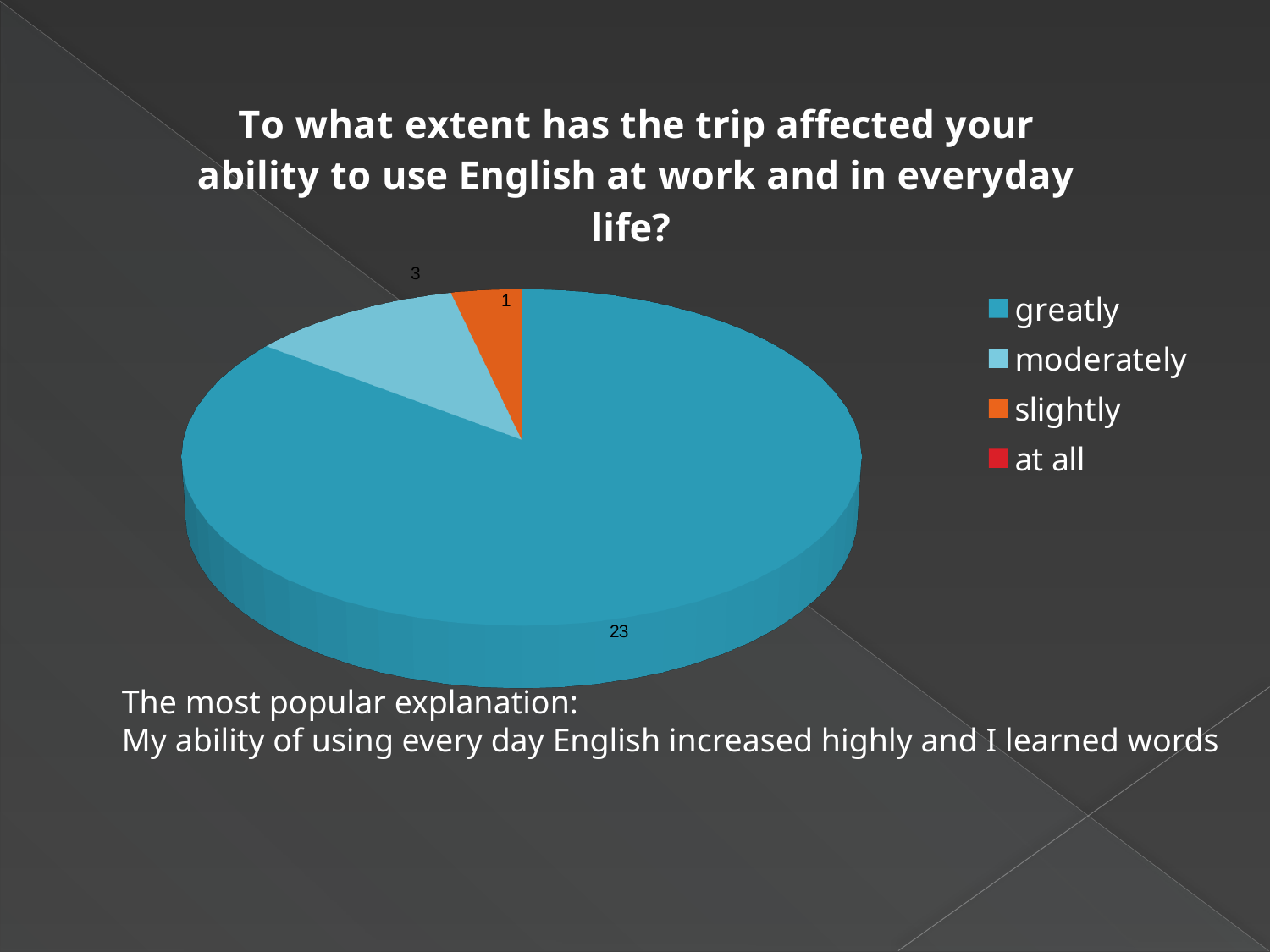
What is the difference between the 'greatly' value and the 'moderately' value? 20 What is the value for the 'moderately' slice? 3 What is the title of the chart? To what extent has the trip affected your ability to use English at work and in everyday life? What is the value for the 'slightly' slice? 1 Which is larger, the 'moderately' slice or the 'slightly' slice? moderately What is the value for the 'greatly' slice? 23 Which category is shown in orange in the legend? slightly What is the difference between the 'greatly' value and the 'slightly' value? 22 How many categories does the legend list? 4 Which category has the largest slice of the pie? greatly What kind of chart is shown on the slide? pie chart What is the difference between the 'moderately' value and the 'slightly' value? 2